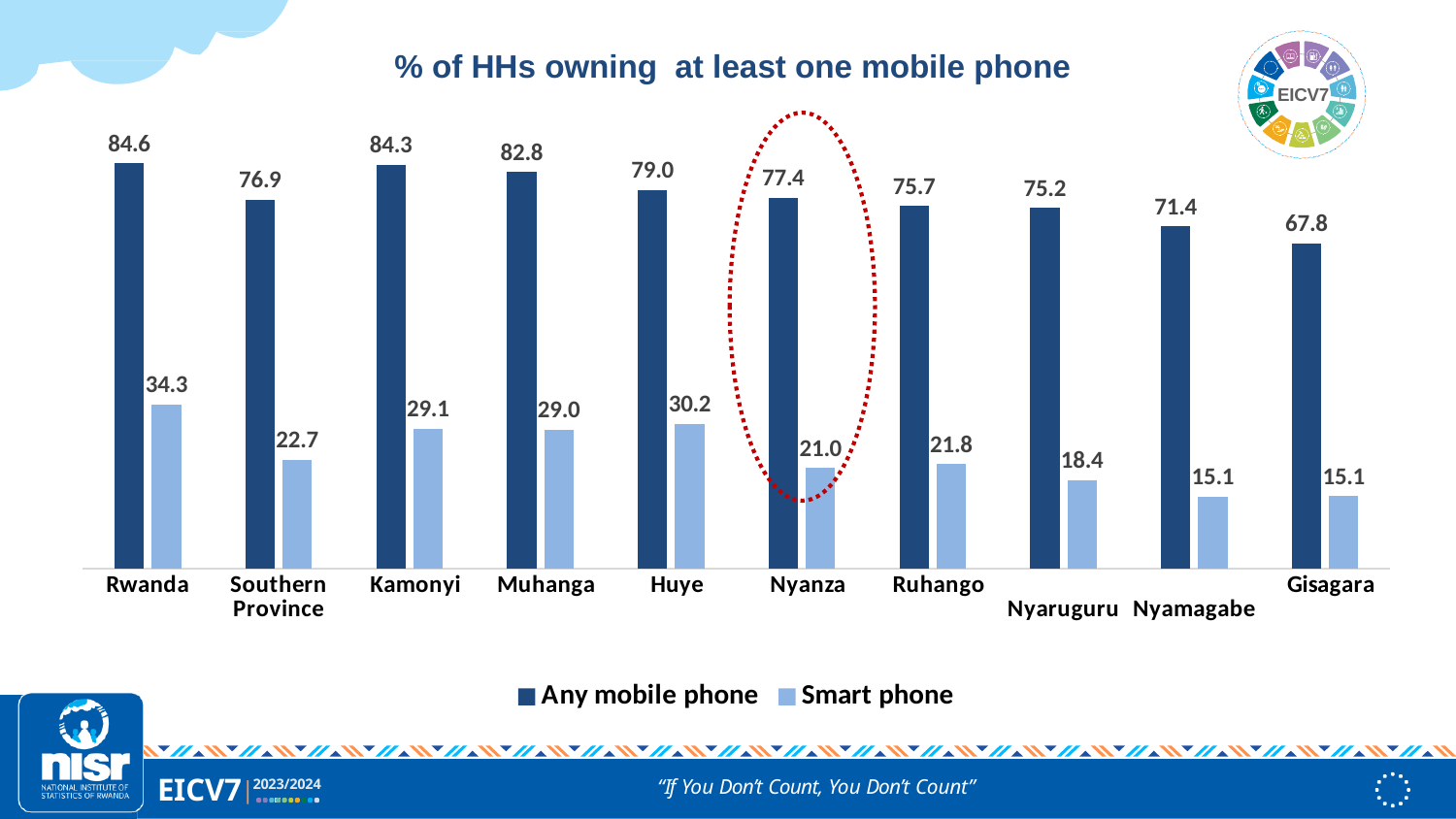
Which category has the highest Any mobile phone value? Rwanda Which category is highlighted with a red dotted circle? Nyanza How many categories are shown on the x axis? 10 What is the difference between the Any mobile phone values for Kamonyi and Gisagara? 16.5 What is the value for Any mobile phone in Nyanza? 77.4 What is the Smart phone value for Huye? 30.2 Which category has the lowest Any mobile phone value? Gisagara Which category has the highest Smart phone value? Rwanda What is the difference between the Any mobile phone and Smart phone values for Nyanza? 56.4 How many series does the legend list? 2 What is the Any mobile phone value for Gisagara? 67.8 Which has a larger Smart phone value, Huye or Kamonyi? Huye